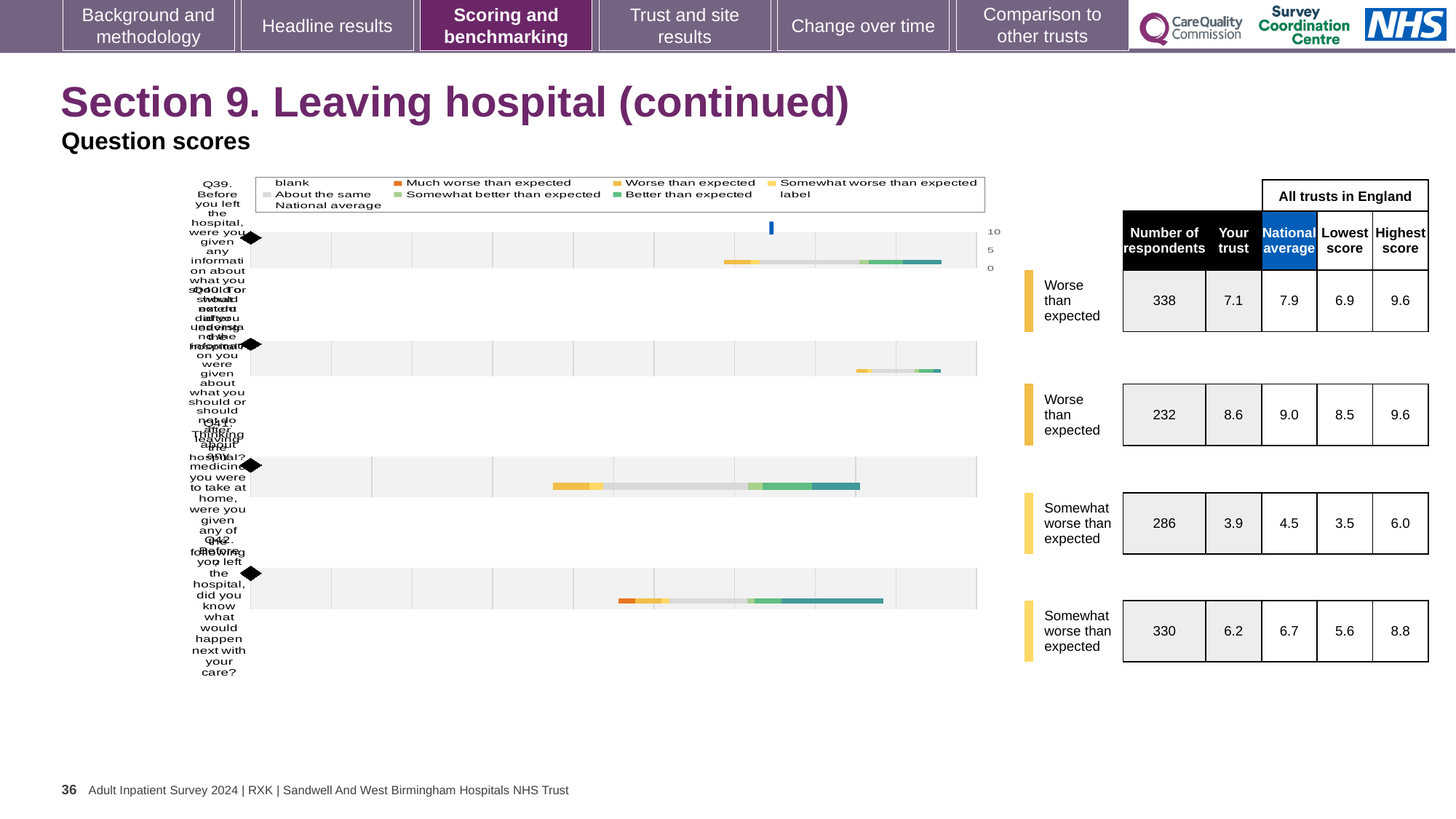
How many question bars are plotted in the chart on the left? 4 Which row of the table has the highest 'Your trust' score? The second row (8.6) For the first (top) row, Q39, which is larger: the 'Your trust' score or the national average? National average What kind of chart is shown on the left of the slide? bar chart In the table, what is the 'Your trust' score for the first (top) row, Q39? 7.1 Which row of the table has the lowest 'Your trust' score? The third row (3.9) In the table, what is the number of respondents for the first (top) row, Q39? 338 In the table, what is the highest score for the third row (286 respondents)? 6.0 What heading spans the National average, Lowest score and Highest score columns of the table? All trusts in England According to the chart legend, what does the blue marker represent? National average For the last (bottom) row, Q42, what is the difference between the highest score and the lowest score? 3.2 In the table, what is the national average for the last (bottom) row, Q42? 6.7